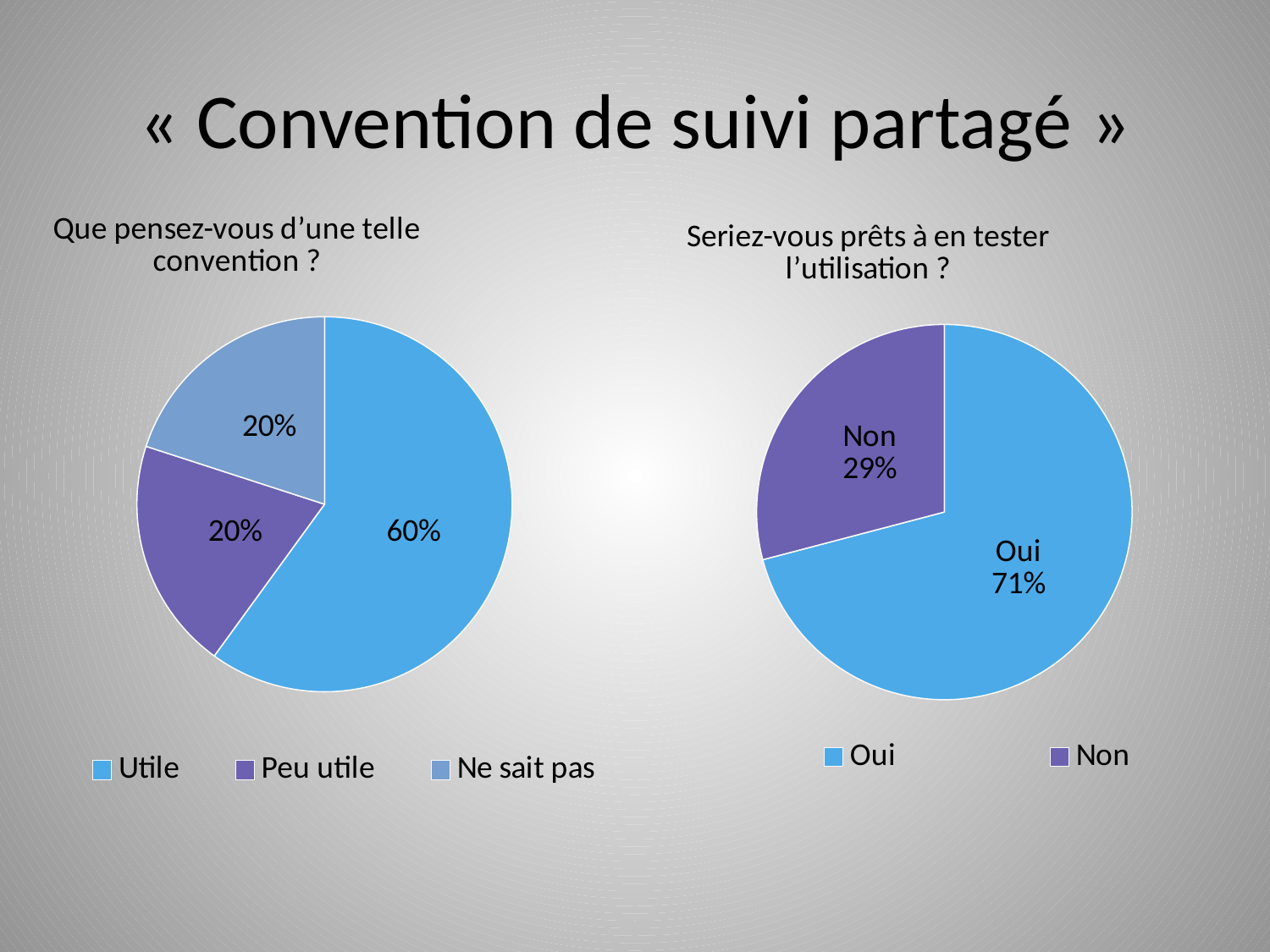
In the right chart 'Seriez-vous prêts à en tester l'utilisation ?', what share of the pie is 'Non'? 29% In the right chart 'Seriez-vous prêts à en tester l'utilisation ?', how many slices does the pie have? 2 In the right chart 'Seriez-vous prêts à en tester l'utilisation ?', what share of the pie is 'Oui'? 71% In the left chart 'Que pensez-vous d'une telle convention ?', how many categories does the legend list? 3 In the left chart 'Que pensez-vous d'une telle convention ?', what share of the pie is 'Ne sait pas'? 20% What kind of chart is the right chart 'Seriez-vous prêts à en tester l'utilisation ?'? Pie chart In the right chart 'Seriez-vous prêts à en tester l'utilisation ?', what is the difference between the 'Oui' share and the 'Non' share? 42% In the left chart 'Que pensez-vous d'une telle convention ?', what is the difference between the 'Utile' share and the 'Peu utile' share? 40% In the left chart 'Que pensez-vous d'une telle convention ?', which category has the largest slice? Utile In the right chart 'Seriez-vous prêts à en tester l'utilisation ?', which is larger, 'Oui' or 'Non'? Oui